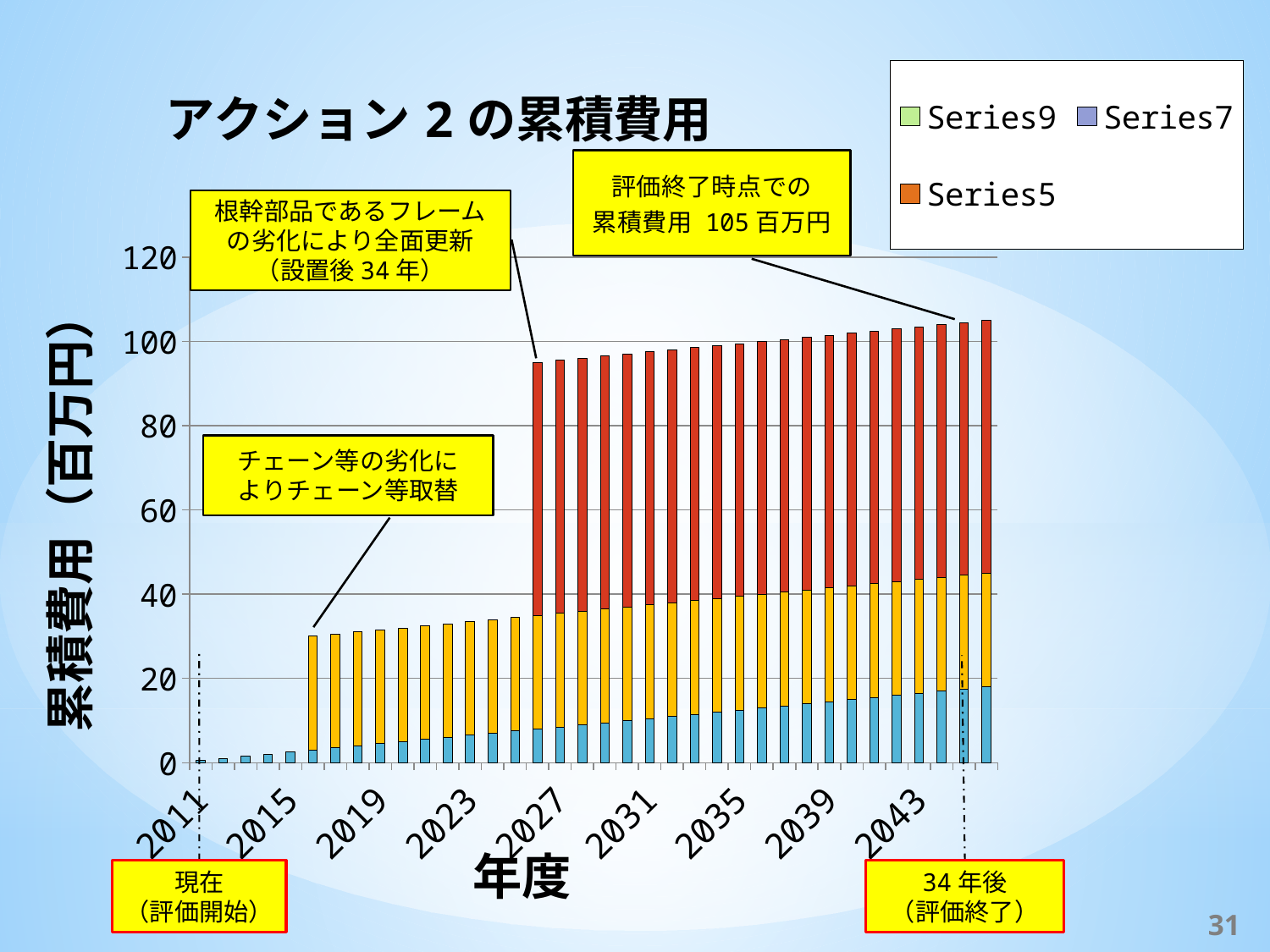
What kind of chart is shown on the slide? Stacked bar chart Do the cumulative cost values rise or fall as the years increase along the x axis? Rise Which year has the larger total cumulative cost, 2023 or 2031? 2031 Is the total cumulative cost for 2015 greater or less than 20? less Is the total cumulative cost for 2035 greater or less than 60? greater Which year has the lowest cumulative cost? 2011 What is the label of the y axis? 累積費用（百万円） How many series does the legend list? 3 Is the total cumulative cost for 2027 greater or less than 80? greater What is the title of the chart? アクション２の累積費用 According to the annotation, what is the cumulative cost at the end of the evaluation period? 105百万円